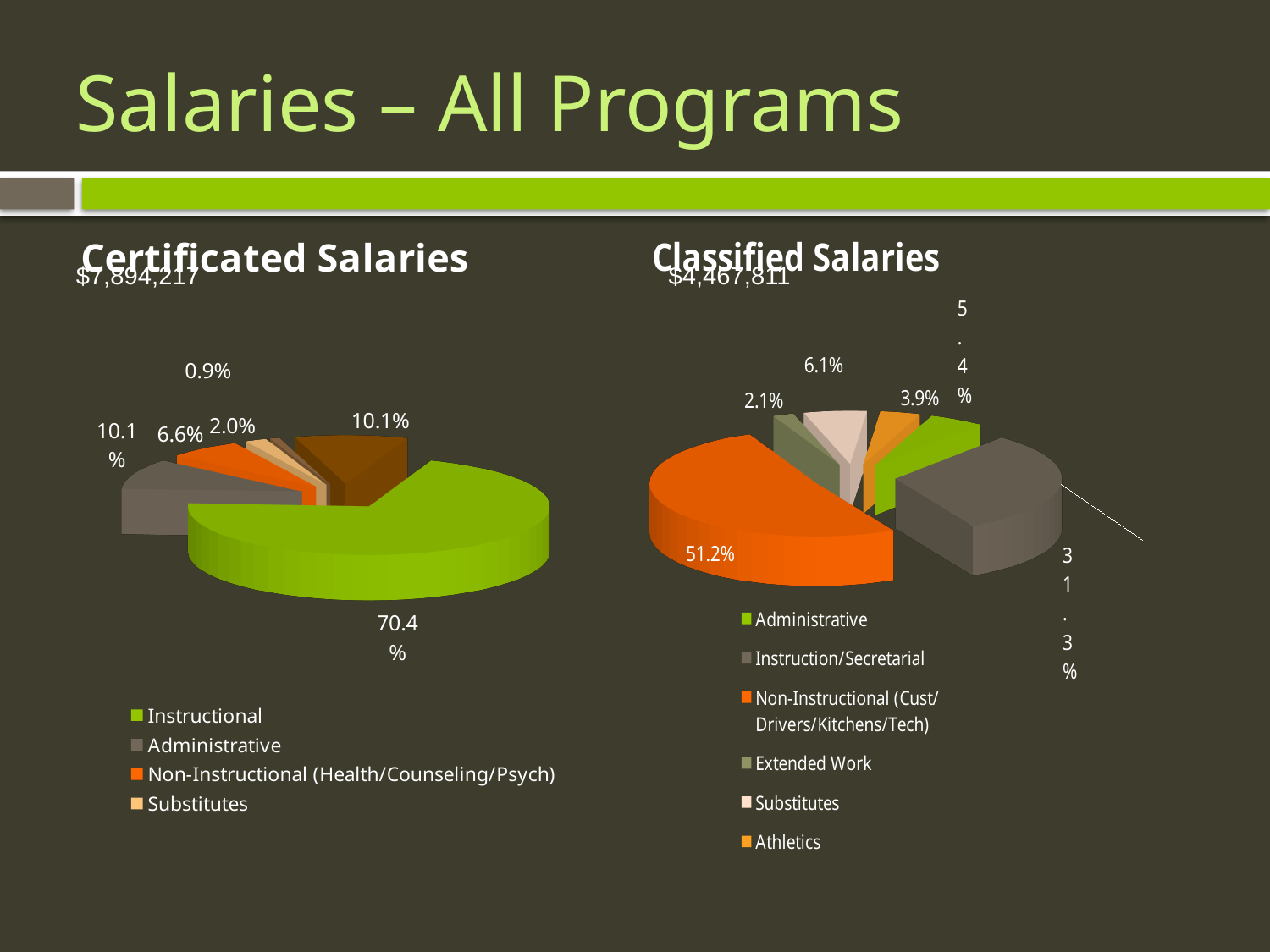
In the Certificated Salaries chart, what is the smallest percentage shown? 0.9% In the Certificated Salaries chart, which category has the largest slice? Instructional In the Certificated Salaries chart, what share does Substitutes have? 2.0% In the Certificated Salaries chart, what share does Instructional have? 70.4% In the Classified Salaries chart, which category has the largest slice? Non-Instructional (Cust/Drivers/Kitchens/Tech) How many entries does the legend of the Classified Salaries chart list? 6 In the Certificated Salaries chart, what share does Non-Instructional (Health/Counseling/Psych) have? 6.6% What total dollar amount is shown for Classified Salaries? $4,467,811 What type of chart is used for Certificated Salaries? Pie chart How many entries does the legend of the Certificated Salaries chart list? 4